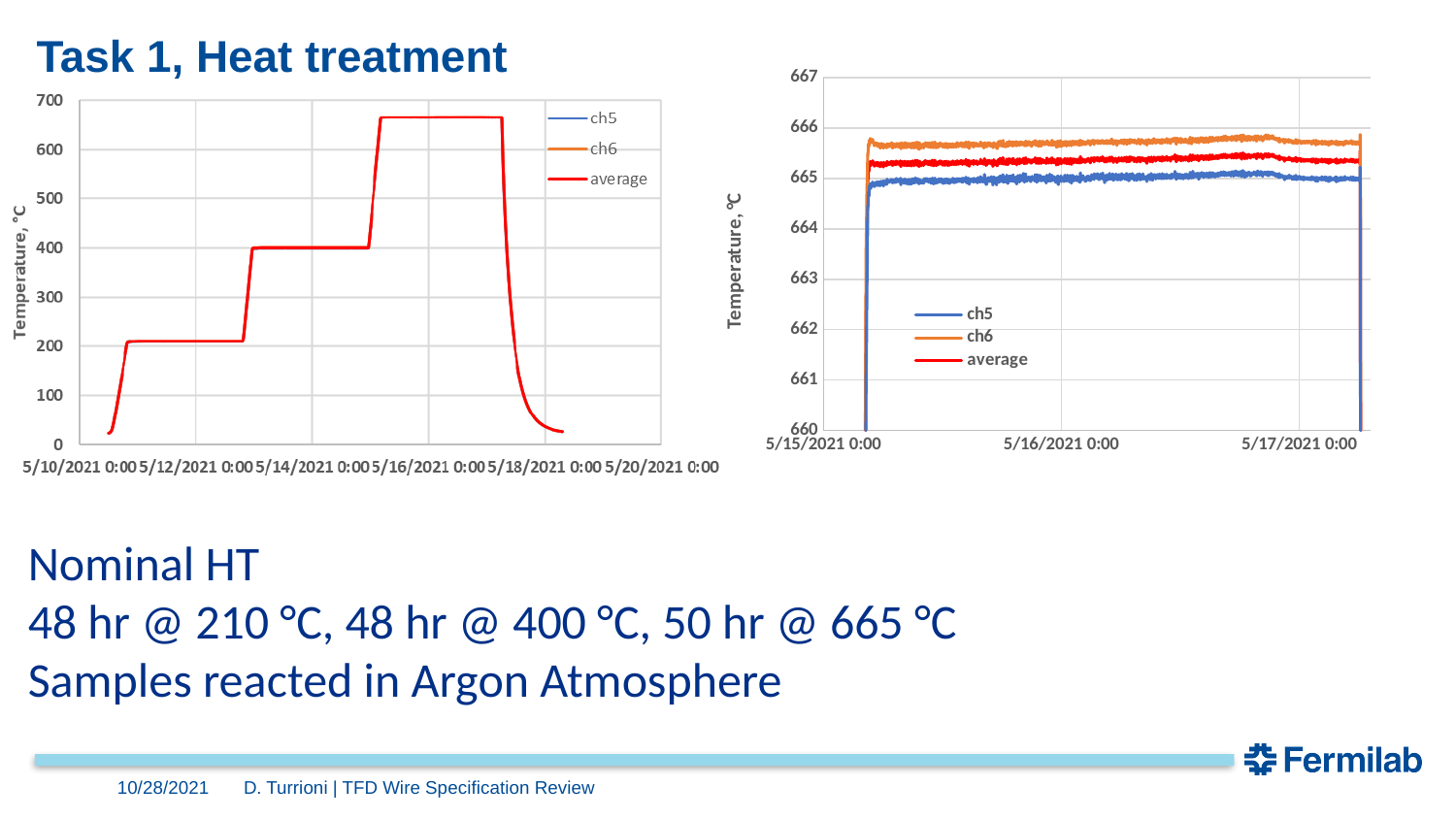
In the right chart, which series is higher, ch5 or ch6? ch6 What kind of chart is the left chart on the slide? line chart In the right chart, which series has the highest temperature? ch6 How many series does the legend of the right chart list? 3 In the left chart, is the highest plateau temperature greater or less than 600? greater What is the y-axis label of the left chart? Temperature, °C In the left chart, does the temperature rise or fall between 5/12/2021 and 5/16/2021? rise In the right chart, is the value for average greater or less than 666? less In the right chart, what colour is the line for the average series? red In the right chart, is the value for ch6 greater or less than 665? greater In the right chart, which series has the lowest temperature? ch5